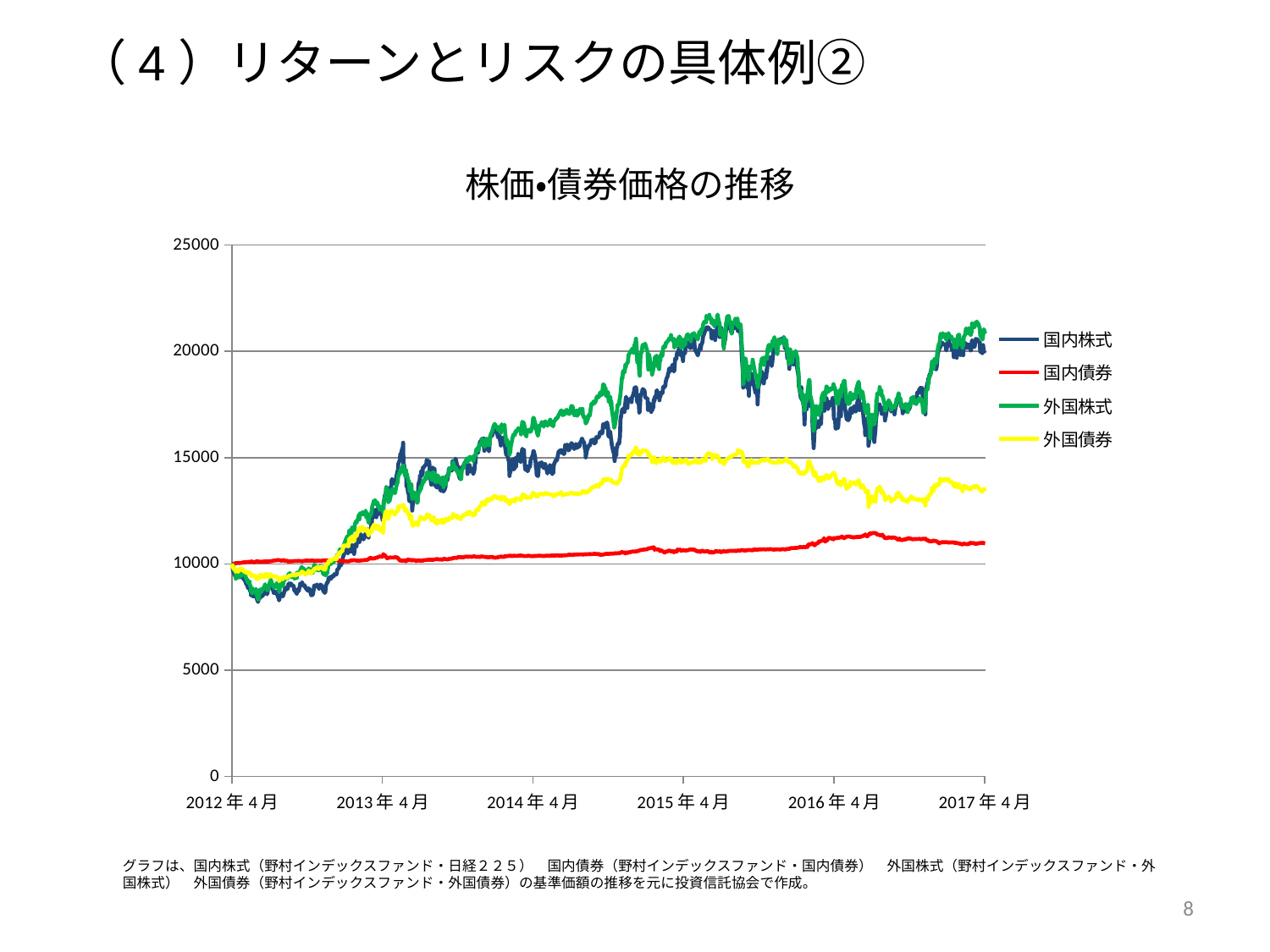
How many year labels are shown along the x axis? 6 Is the value for 国内債券 at 2017年4月 greater or less than 15000? less What kind of chart is shown on the slide? line chart Which series has the lowest value at 2017年4月? 国内債券 Is the value for 外国債券 at 2017年4月 greater or less than 10000? greater What is the title of the chart? 株価•債券価格の推移 Does the 外国債券 line rise or fall between 2015年4月 and 2017年4月? fall At 2016年4月, which is larger, 外国債券 or 国内債券? 外国債券 Is the value for 外国株式 at 2015年4月 greater or less than 15000? greater How many series does the legend list? 4 Which series is drawn in red? 国内債券